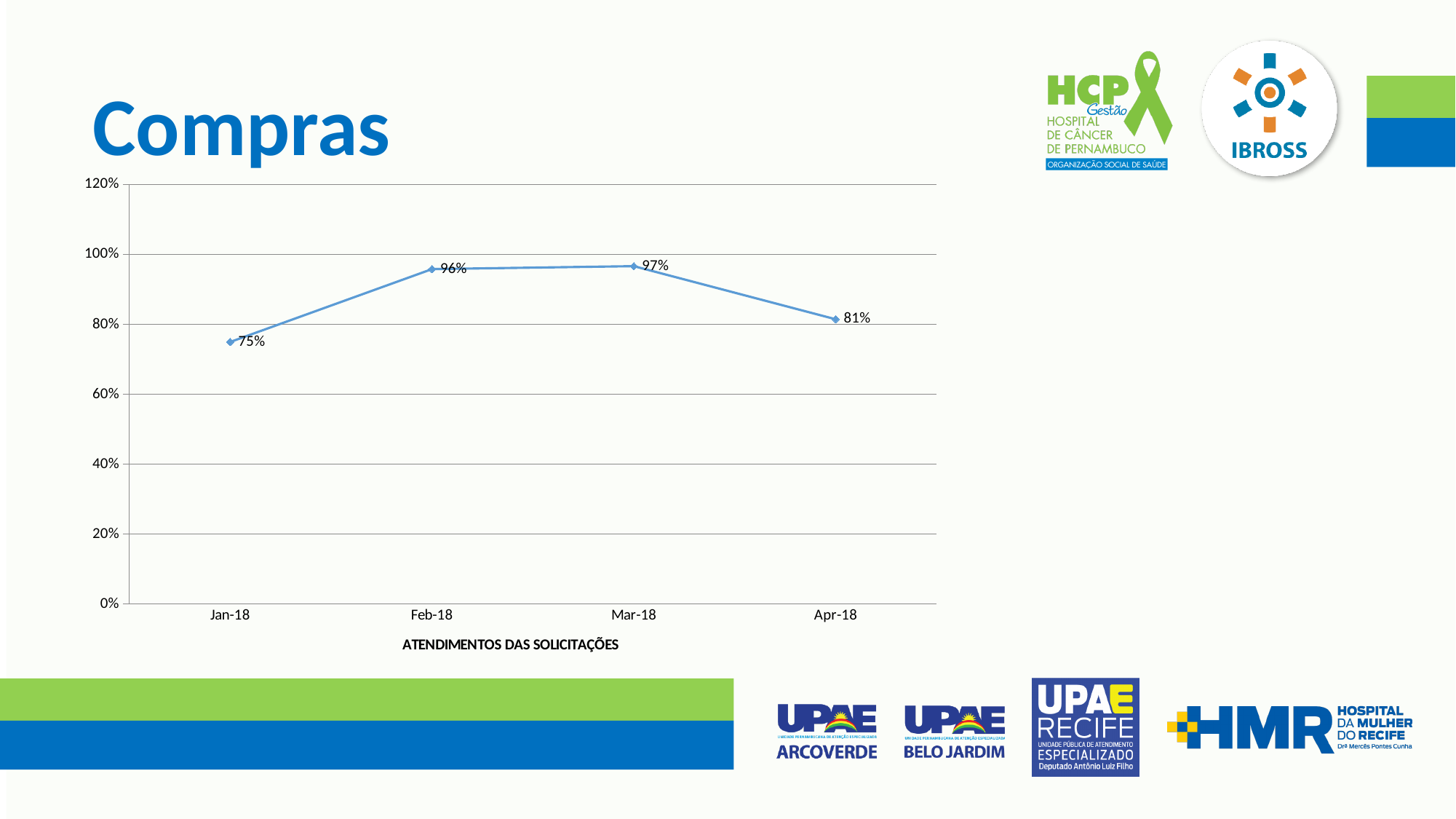
How many months are plotted on the chart? 4 What is the difference between the values for Feb-18 and Jan-18? 21% What kind of chart is shown on the slide? line chart What is the value for Jan-18? 75% What is the value for Feb-18? 96% What is the label shown below the x axis of the chart? ATENDIMENTOS DAS SOLICITAÇÕES Is the value for Jan-18 greater or less than 80%? less Which is larger, the value for Feb-18 or the value for Apr-18? Feb-18 What is the value for Apr-18? 81% Which month has the lowest value? Jan-18 What is the value for Mar-18? 97% What is the difference between the values for Mar-18 and Apr-18? 16%